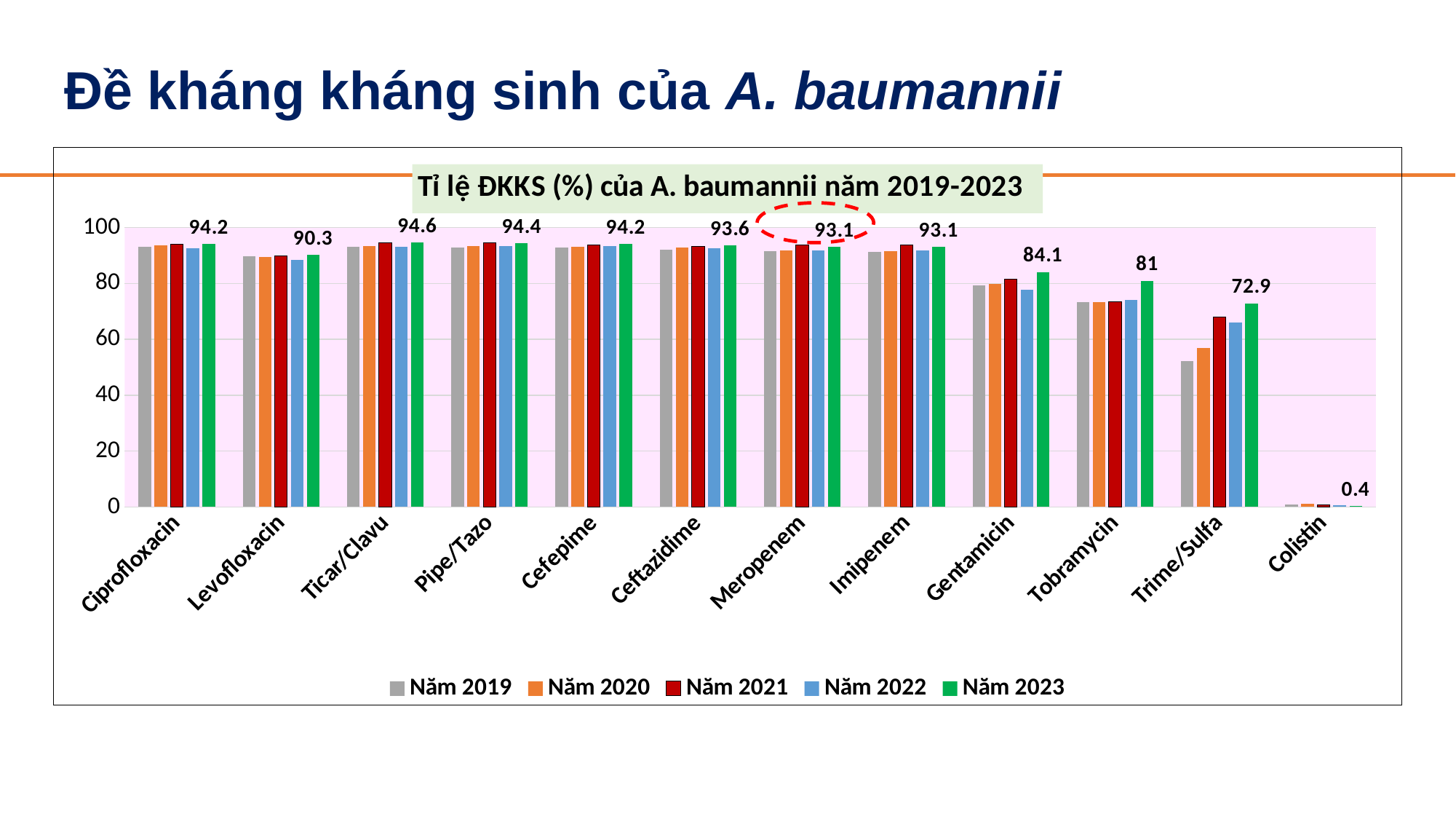
What is the value for Colistin in Năm 2023? 0.4 How many series does the legend list? 5 Which antibiotic has the highest Năm 2023 value? Ticar/Clavu What kind of chart is shown on the slide? Bar chart Which antibiotic has the lowest Năm 2023 value? Colistin How many antibiotics are shown on the x axis? 12 Is the value for Trime/Sulfa in Năm 2019 greater or less than 60? less Which is larger in Năm 2023: Trime/Sulfa or Tobramycin? Tobramycin What is the difference between the Năm 2023 values for Gentamicin and Tobramycin? 3.1 What is the value for Gentamicin in Năm 2023? 84.1 Is the value for Gentamicin in Năm 2022 greater or less than 80? less What is the value for Ticar/Clavu in Năm 2023? 94.6